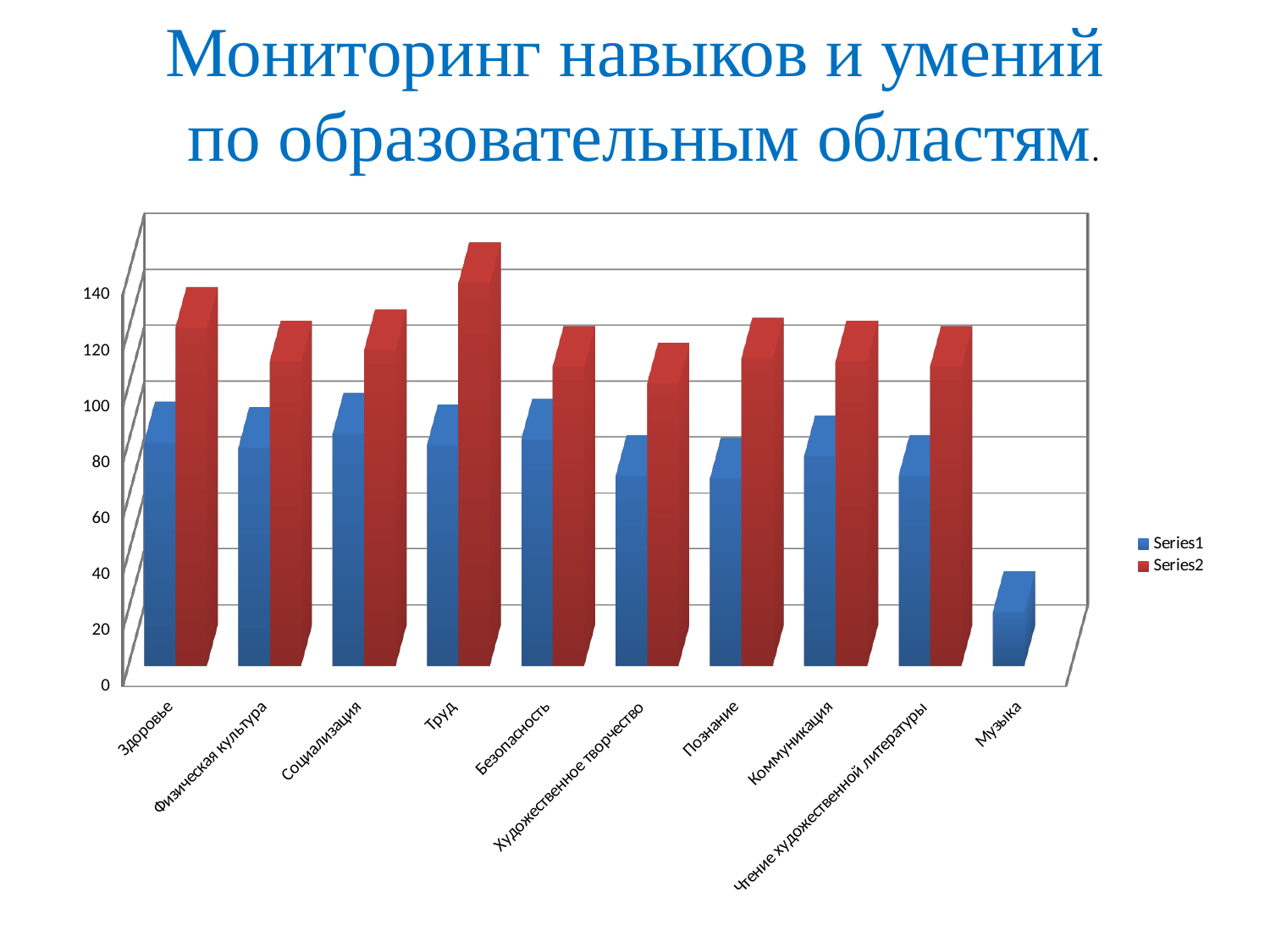
What are the two entries listed in the chart legend? Series1, Series2 What kind of chart is shown on the slide? bar chart What colour are the Series2 bars in the chart? red Which is larger for Здоровье: the Series1 value or the Series2 value? Series2 Which category has the tallest Series2 bar? Труд How many series does the chart legend list? 2 Which category has the lowest Series1 value? Музыка How many categories are shown along the x axis of the chart? 10 Which Series1 value is larger: Познание or Музыка? Познание